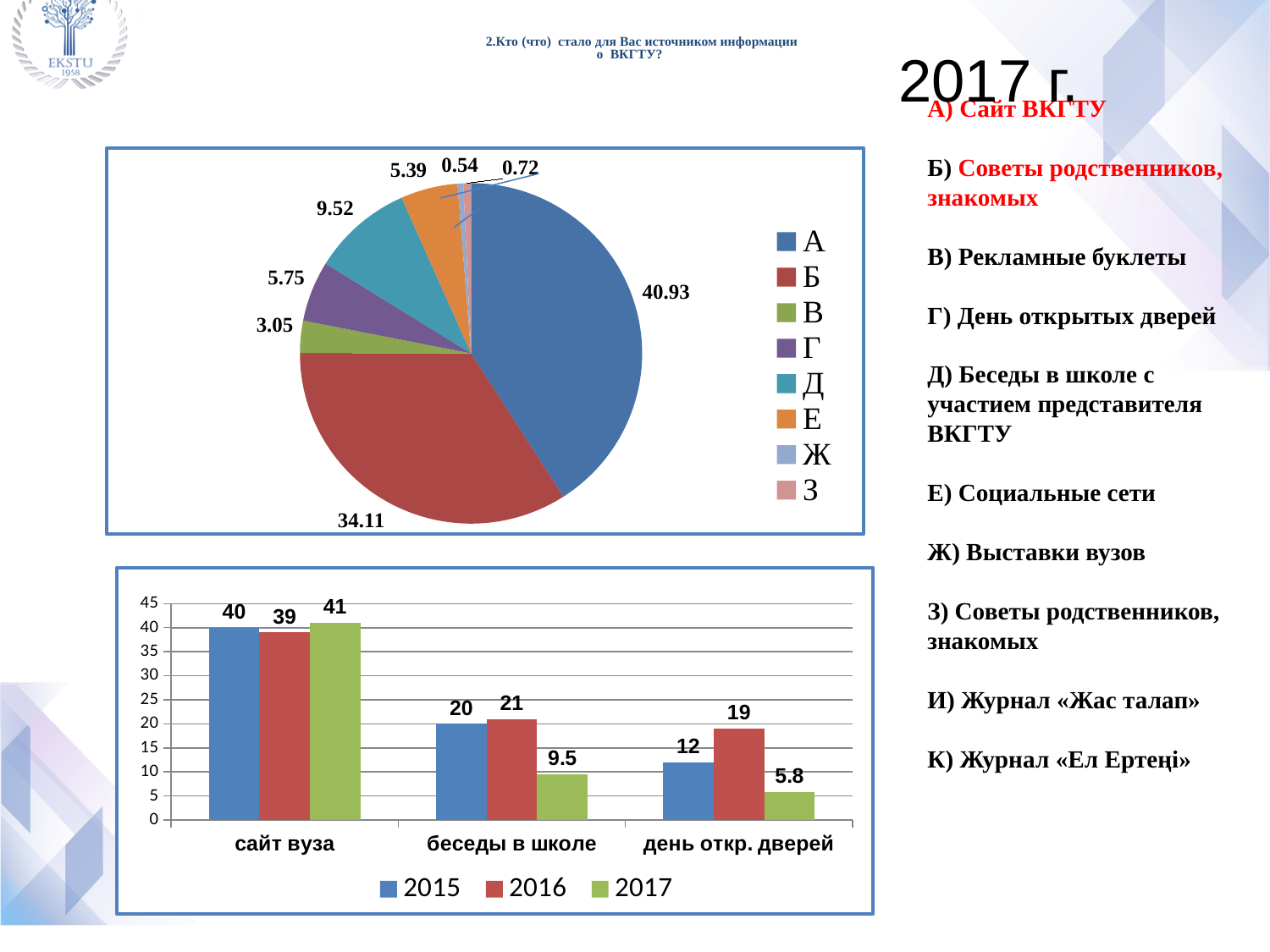
In the top pie chart, what is the difference between the values for А and Б? 6.82 In the bottom bar chart, which year has the highest value for 'сайт вуза'? 2017 In the top pie chart, how many categories does the legend list? 8 In the bottom bar chart, how many series does the legend list? 3 In the top pie chart, which category has the smallest slice? Ж In the bottom bar chart, which is larger: the 2016 value for 'беседы в школе' or the 2016 value for 'день откр. дверей'? беседы в школе In the bottom bar chart, what is the difference between the 2015 and 2017 values for 'день откр. дверей'? 6.2 In the top pie chart, what is the value for category Д? 9.52 In the bottom bar chart, what is the value for 2017 in the category 'беседы в школе'? 9.5 In the top pie chart, what is the value for category А? 40.93 What type of chart is the bottom chart? bar chart In the bottom bar chart, what is the value for 2016 in the category 'день откр. дверей'? 19